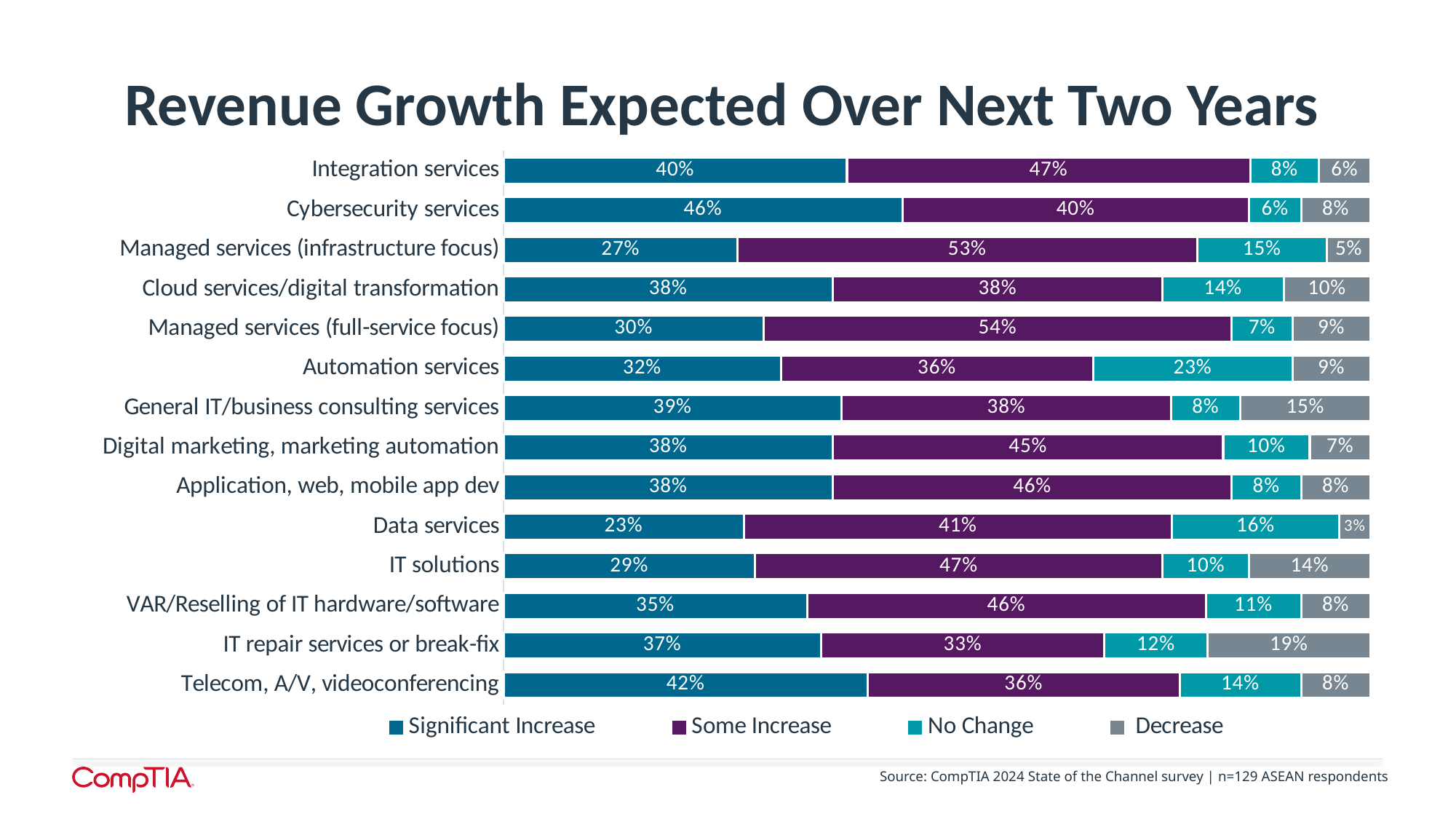
How many categories are plotted on the chart? 14 Which category has the lowest Significant Increase value? Data services Which category has the highest Significant Increase value? Cybersecurity services Which category has the highest Some Increase value? Managed services (full-service focus) What is the Decrease value for IT repair services or break-fix? 19% What is the difference between the Significant Increase values for Telecom, A/V, videoconferencing and Data services? 19% What is the No Change value for Automation services? 23% What is the Significant Increase value for Cybersecurity services? 46% What kind of chart is shown on the slide? bar chart What is the Some Increase value for Managed services (infrastructure focus)? 53% Which is larger: the Decrease value for General IT/business consulting services or for IT solutions? General IT/business consulting services How many series does the legend list? 4